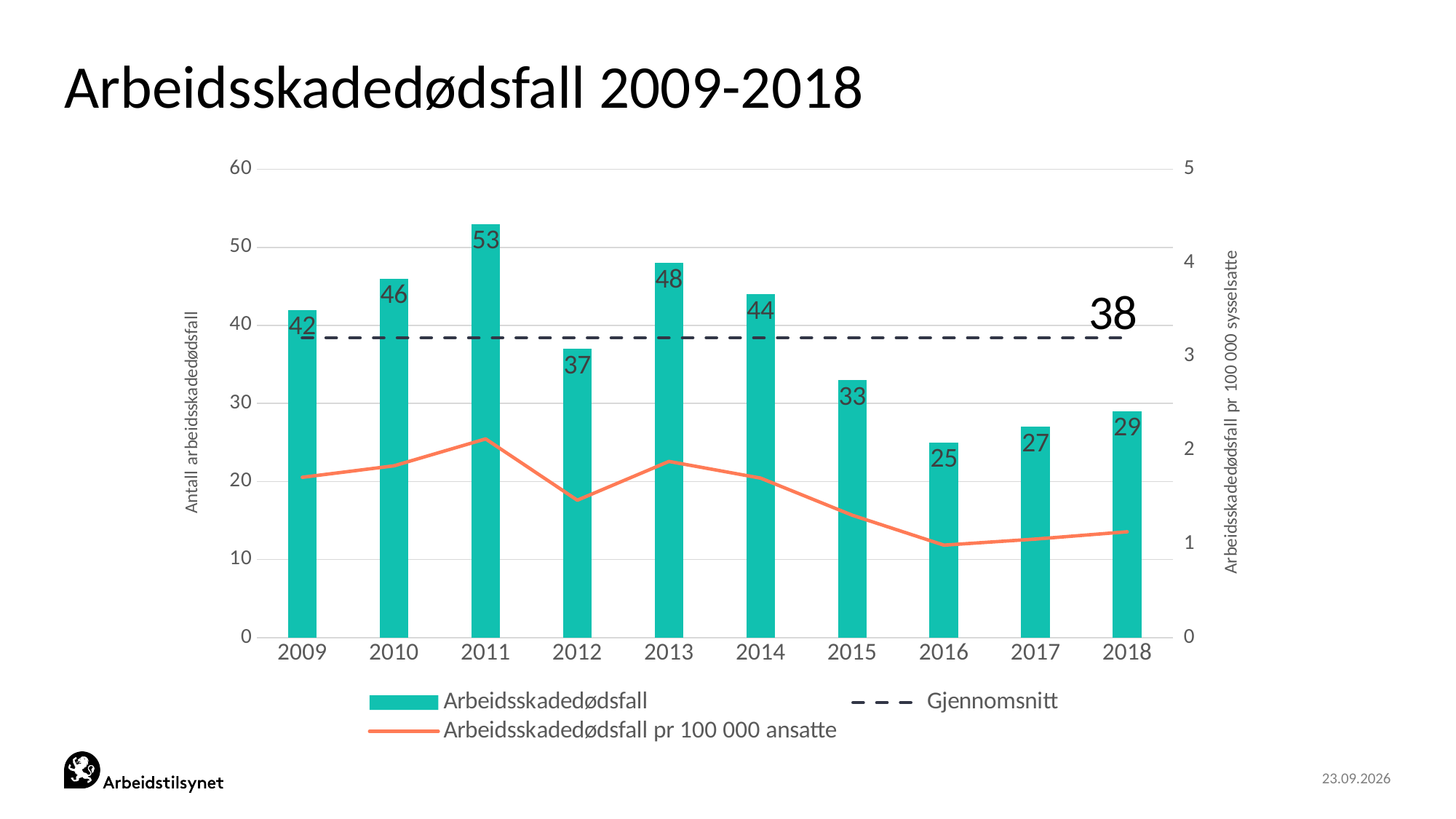
Is the value of Arbeidsskadedødsfall pr 100 000 ansatte for 2011 greater or less than 2 on the right axis? greater How many series does the legend list? 3 How many years are shown on the x axis? 10 Which year has the lowest number of Arbeidsskadedødsfall? 2016 Which year has the highest number of Arbeidsskadedødsfall? 2011 What value is shown for the Gjennomsnitt (average) line? 38 Do the Arbeidsskadedødsfall values generally rise or fall from 2013 to 2016? Fall Which year has more Arbeidsskadedødsfall, 2013 or 2014? 2013 What kind of chart is used for the Arbeidsskadedødsfall series? Bar chart What is the value of Arbeidsskadedødsfall for 2016? 25 What is the difference between the Arbeidsskadedødsfall values for 2011 and 2012? 16 What is the value of Arbeidsskadedødsfall for 2011? 53